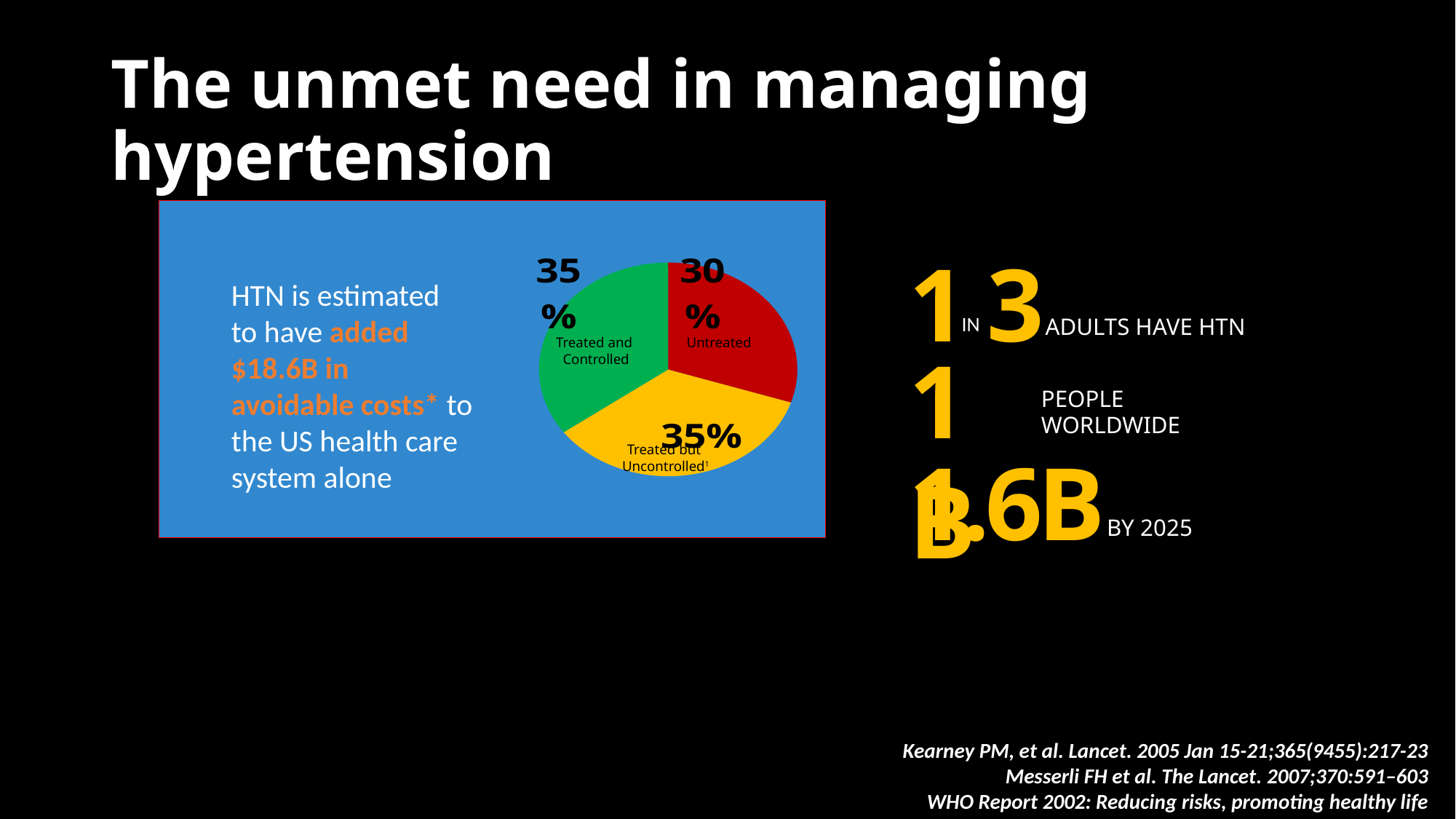
What kind of chart is shown on the slide? pie chart What colour is the Treated and Controlled slice of the pie chart? green What percentage of the pie chart is labelled Treated but Uncontrolled? 35% What percentage of the pie chart is labelled Treated and Controlled? 35% What colour is the Untreated slice of the pie chart? red What is the combined share of the two treated slices (Treated and Controlled plus Treated but Uncontrolled) in the pie chart? 70% Which is larger in the pie chart, Untreated or Treated and Controlled? Treated and Controlled What is the difference in percentage points between the Treated but Uncontrolled slice and the Untreated slice? 5 What percentage of the pie chart is labelled Untreated? 30% How many slices does the pie chart have? 3 Which slice of the pie chart is the smallest? Untreated